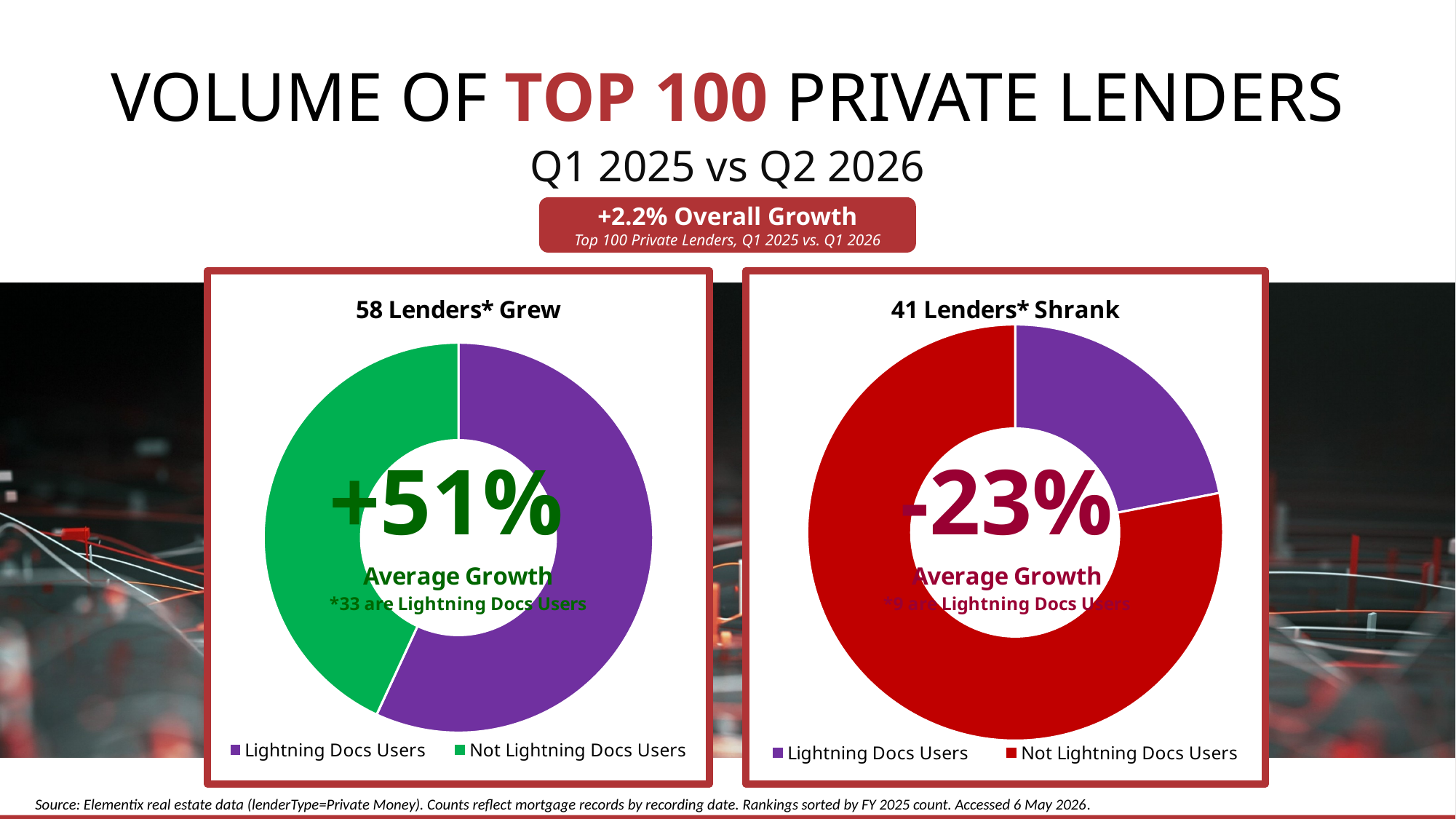
How many lenders are represented in the right chart (lenders that shrank)? 41 In the '41 Lenders* Shrank' chart, how many of the lenders are Lightning Docs Users? 9 In the '58 Lenders* Grew' chart, how many of the lenders are Lightning Docs Users? 33 What average growth is shown in the centre of the '41 Lenders* Shrank' chart? -23% What overall growth figure is shown in the red box above the charts? +2.2% Overall Growth How many more lenders grew than shrank, according to the two chart titles? 17 In the '41 Lenders* Shrank' chart, which slice is the largest? Not Lightning Docs Users In the '58 Lenders* Grew' chart, which slice is larger: Lightning Docs Users or Not Lightning Docs Users? Lightning Docs Users How many lenders are represented in the left chart (lenders that grew)? 58 What kind of chart is used on this slide for the '58 Lenders* Grew' and '41 Lenders* Shrank' panels? doughnut (pie) chart How many entries does the legend of the '58 Lenders* Grew' chart list? 2 What average growth is shown in the centre of the '58 Lenders* Grew' chart? +51%